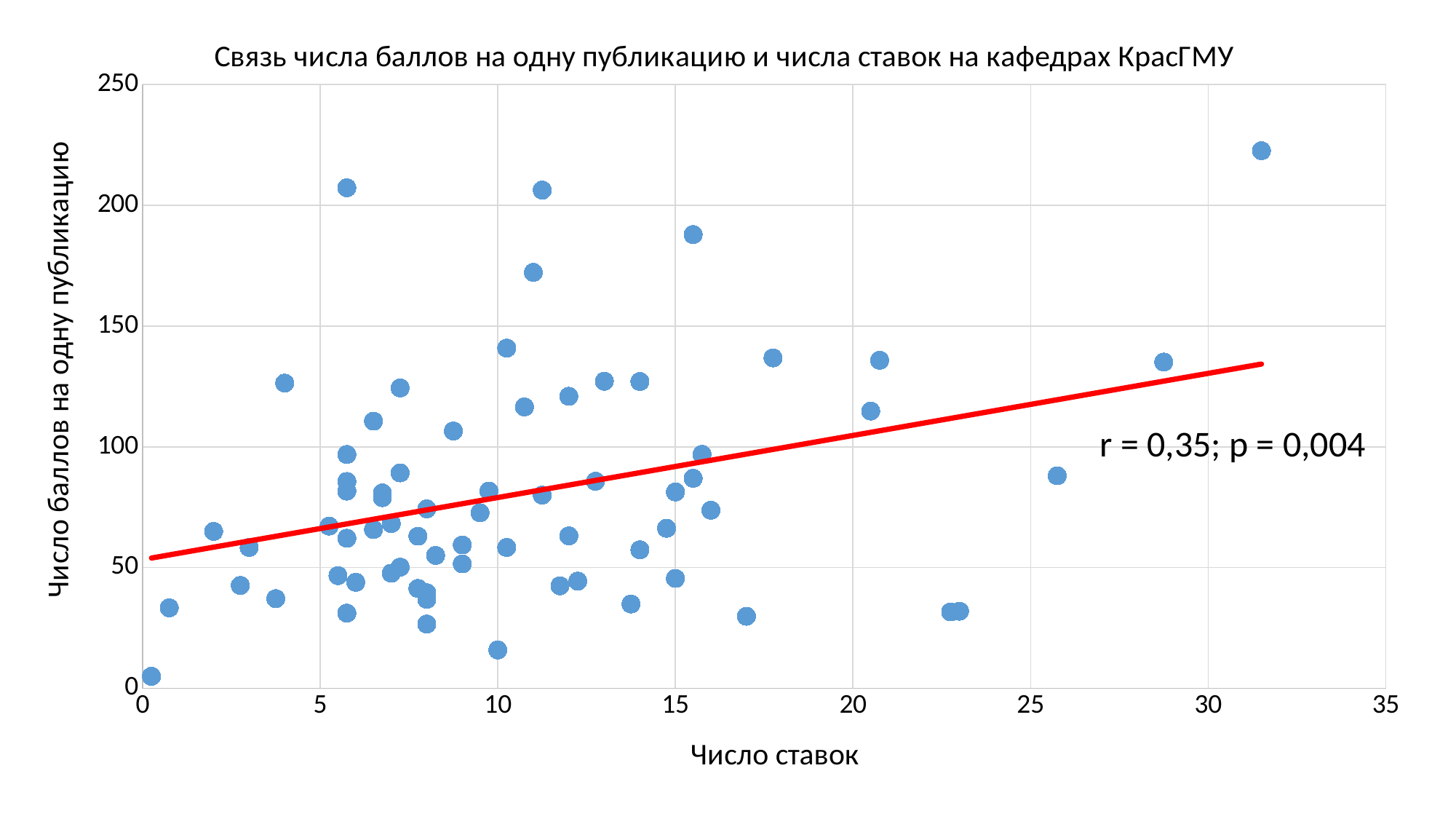
What kind of chart is shown on the slide? scatter plot Is the value for the point at about 26 ставок greater or less than 100? less Does the red trend line rise or fall as the number of ставок increases along the x axis? rises Is the value for the rightmost point (the one with the largest number of ставок) greater or less than 200? greater Which has the higher number of баллов: the rightmost point or the leftmost point? the rightmost point What correlation coefficient and p-value are printed on the chart? r = 0,35; p = 0,004 Is the value for the highest point near 15–16 ставок greater or less than 150? greater What is the title of the chart? Связь числа баллов на одну публикацию и числа ставок на кафедрах КрасГМУ Is the lowest point on the chart located at the far left or the far right of the x axis? far left Does the point with the largest number of ставок have the highest or the lowest number of баллов on the chart? highest